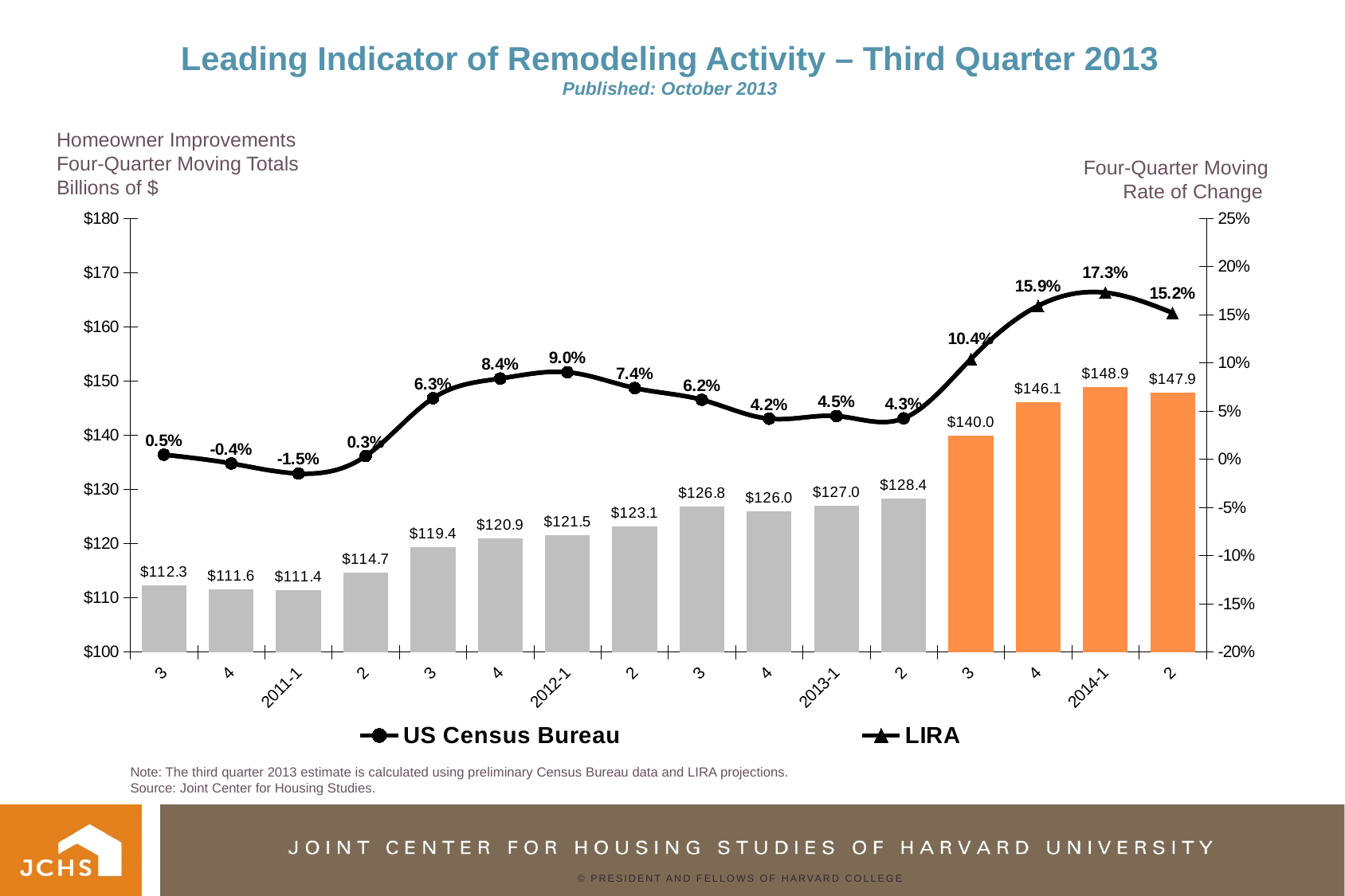
What is the difference between the four-quarter moving totals for 2013-1 and 2012-1? $5.5 What is the four-quarter moving total for 2012-1? $121.5 Which period has the lowest four-quarter moving total bar? 2011-1 ($111.4) Do the four-quarter moving total bars generally rise or fall from left to right? Rise Which period has the lowest four-quarter moving rate of change on the line? 2011-1 (-1.5%) Is the four-quarter moving total bar for 2014-1 greater or less than $140? greater What kind of chart is shown on the slide? Combination bar and line chart Which is larger, the four-quarter moving total for 2013-1 or for 2011-1? 2013-1 How many quarterly periods are shown on the x axis? 16 How many series does the legend list? 2 Which period has the highest four-quarter moving total bar? 2014-1 ($148.9) What is the four-quarter moving rate of change shown for 2014-1? 17.3%